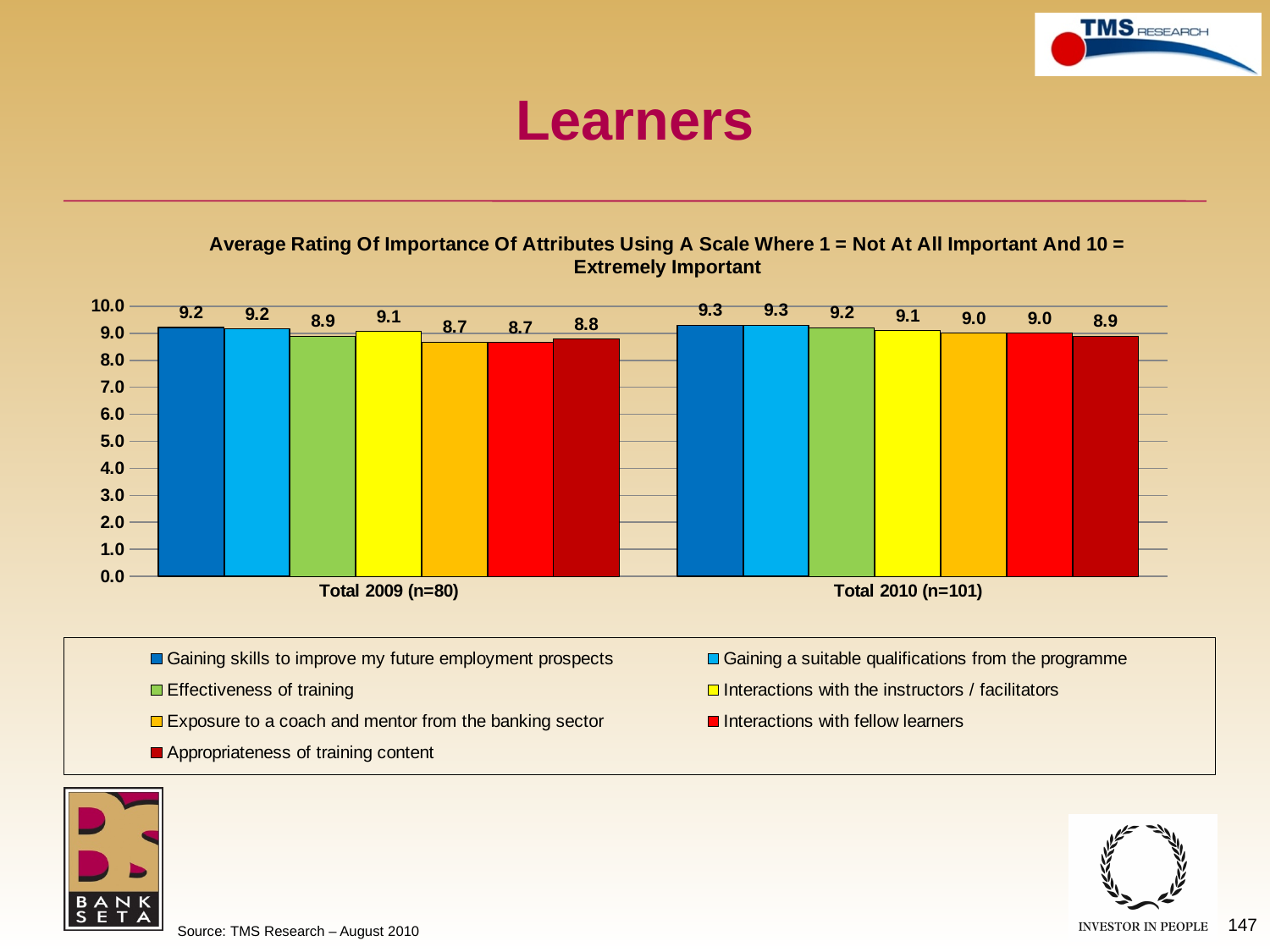
What colour represents Exposure to a coach and mentor from the banking sector in the legend? Orange What is the value for Interactions with the instructors / facilitators in Total 2010 (n=101)? 9.1 What is the value for Exposure to a coach and mentor from the banking sector in Total 2009 (n=80)? 8.7 What is the value for Effectiveness of training in Total 2009 (n=80)? 8.9 Which series has the lowest value in Total 2010 (n=101)? Appropriateness of training content What kind of chart is shown on the slide? Bar chart What is the value for Appropriateness of training content in Total 2010 (n=101)? 8.9 How many series does the legend list? 7 Which is larger: Interactions with fellow learners in Total 2009 (n=80) or in Total 2010 (n=101)? Total 2010 (n=101) How many category groups are shown on the x axis? 2 What is the difference between Gaining skills to improve my future employment prospects and Exposure to a coach and mentor from the banking sector in Total 2009 (n=80)? 0.5 What is the difference between the Effectiveness of training values for Total 2010 (n=101) and Total 2009 (n=80)? 0.3